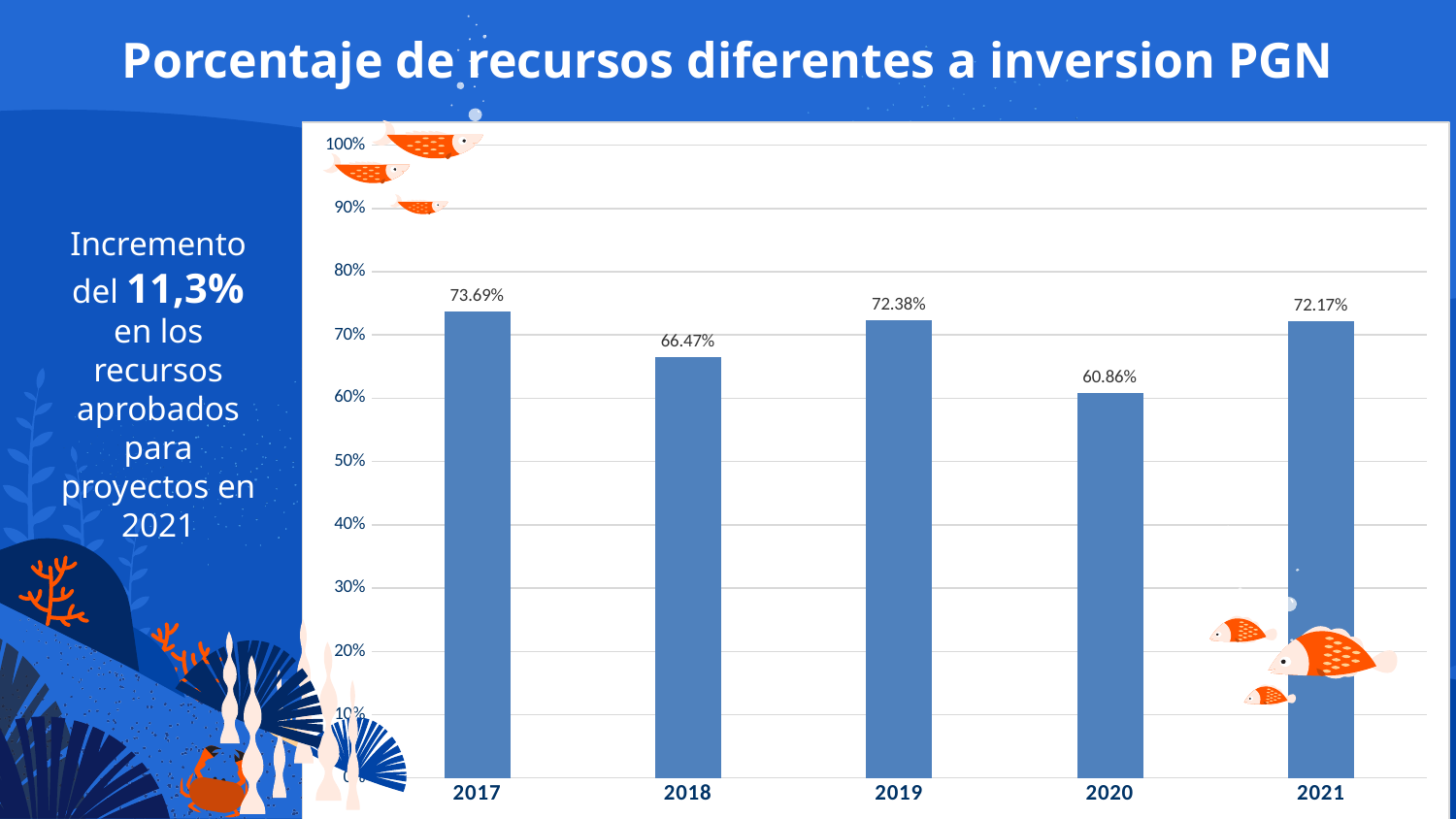
What is the title of the chart? Porcentaje de recursos diferentes a inversion PGN Which is larger, the value for 2018 or the value for 2019? 2019 Is the value for 2020 greater or less than 70%? less What is the difference between the values for 2021 and 2020? 11.31% What is the value for 2017? 73.69% Which year has the highest value? 2017 What kind of chart is shown on the slide? bar chart What is the value for 2020? 60.86% Which year has the lowest value? 2020 How many years are shown on the x axis? 5 What is the difference between the values for 2017 and 2018? 7.22% What is the value for 2021? 72.17%